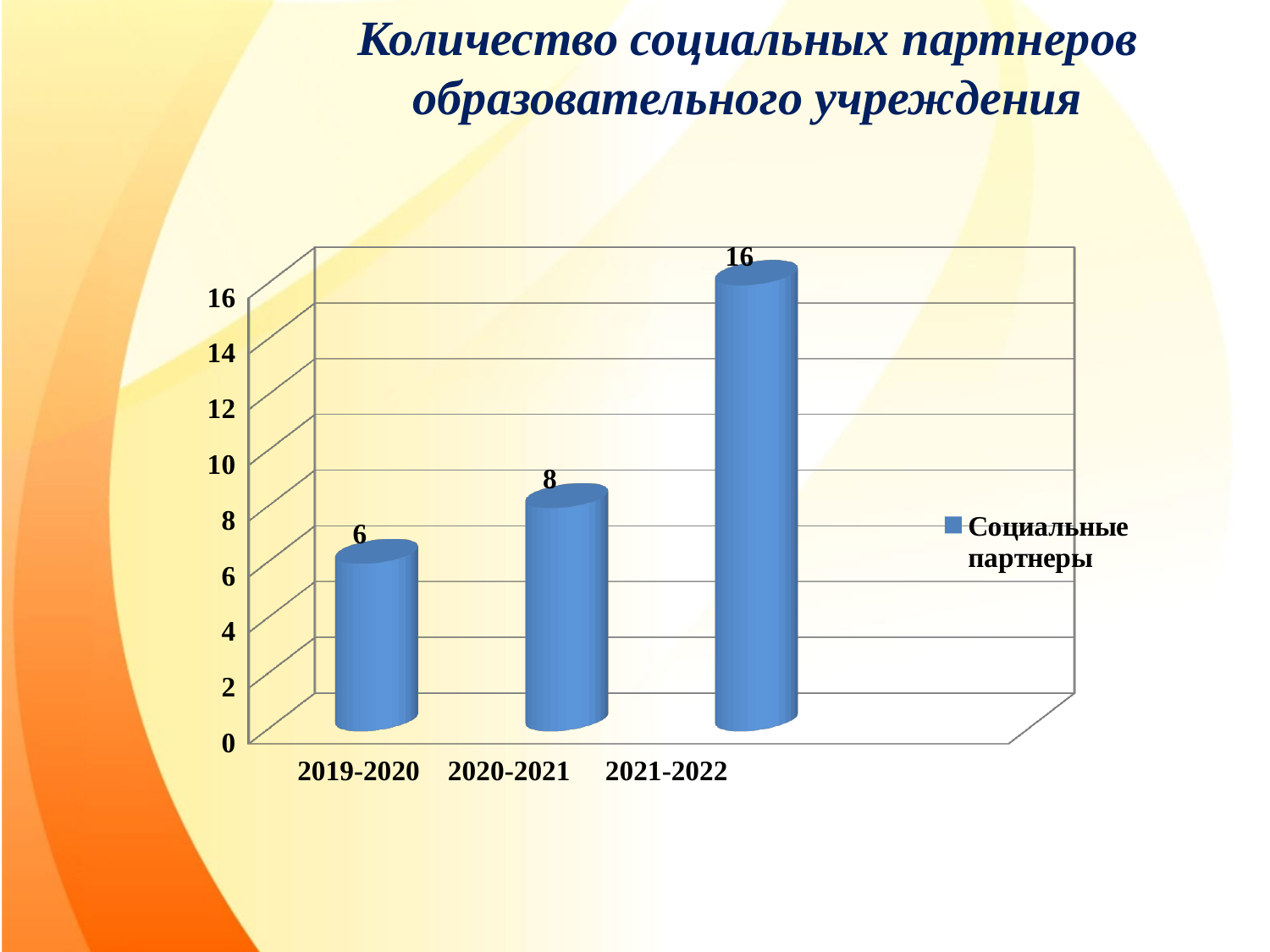
Do the values rise or fall from 2019-2020 to 2021-2022? Rise What is the difference between the values for 2021-2022 and 2020-2021? 8 How many series does the legend list? 1 What is the difference between the values for 2020-2021 and 2019-2020? 2 What kind of chart is shown on the slide? Bar chart How many periods are shown on the x axis? 3 Which period has the highest number of social partners? 2021-2022 What is the value for 2019-2020? 6 Which is larger, the value for 2019-2020 or the value for 2020-2021? 2020-2021 What is the value for 2020-2021? 8 What is the value for 2021-2022? 16 Which period has the lowest number of social partners? 2019-2020